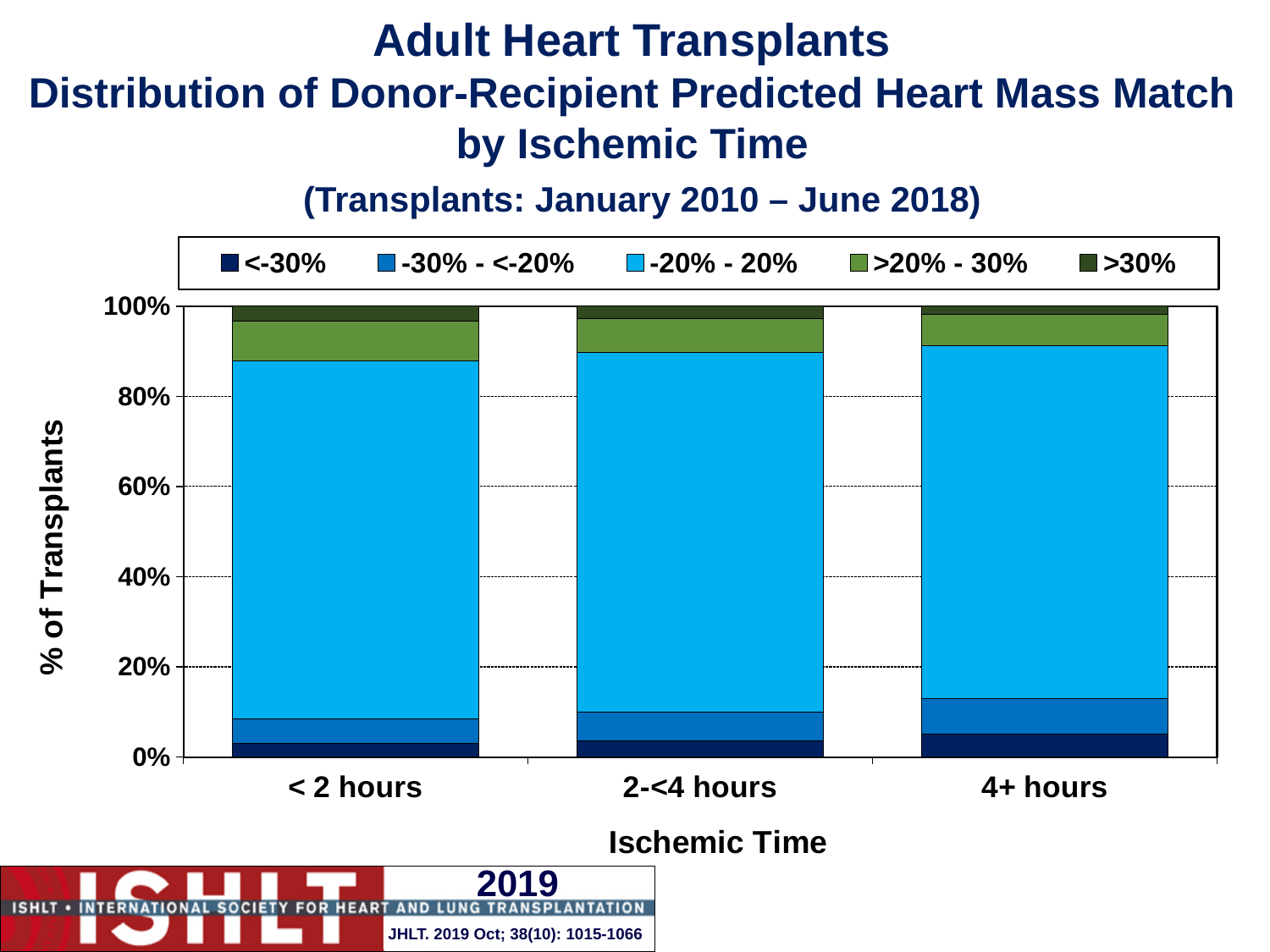
Which predicted heart mass match category makes up the largest share of transplants in every ischemic time group? -20% - 20% What is the total of each stacked bar on the chart? 100% Is the share of transplants in the >20% - 30% category for < 2 hours greater or less than 20%? less Is the share of transplants in the -20% - 20% category for 4+ hours greater or less than 60%? greater Does the share of transplants in the <-30% category rise or fall as ischemic time increases from < 2 hours to 4+ hours? rise How many series does the legend list? 5 What is the title of the x axis? Ischemic Time What transplant period is stated in the chart title? January 2010 – June 2018 What kind of chart is shown on the slide? Stacked bar chart Is the share of transplants in the -20% - 20% category for < 2 hours greater or less than 60%? greater How many ischemic time categories are shown on the x axis? 3